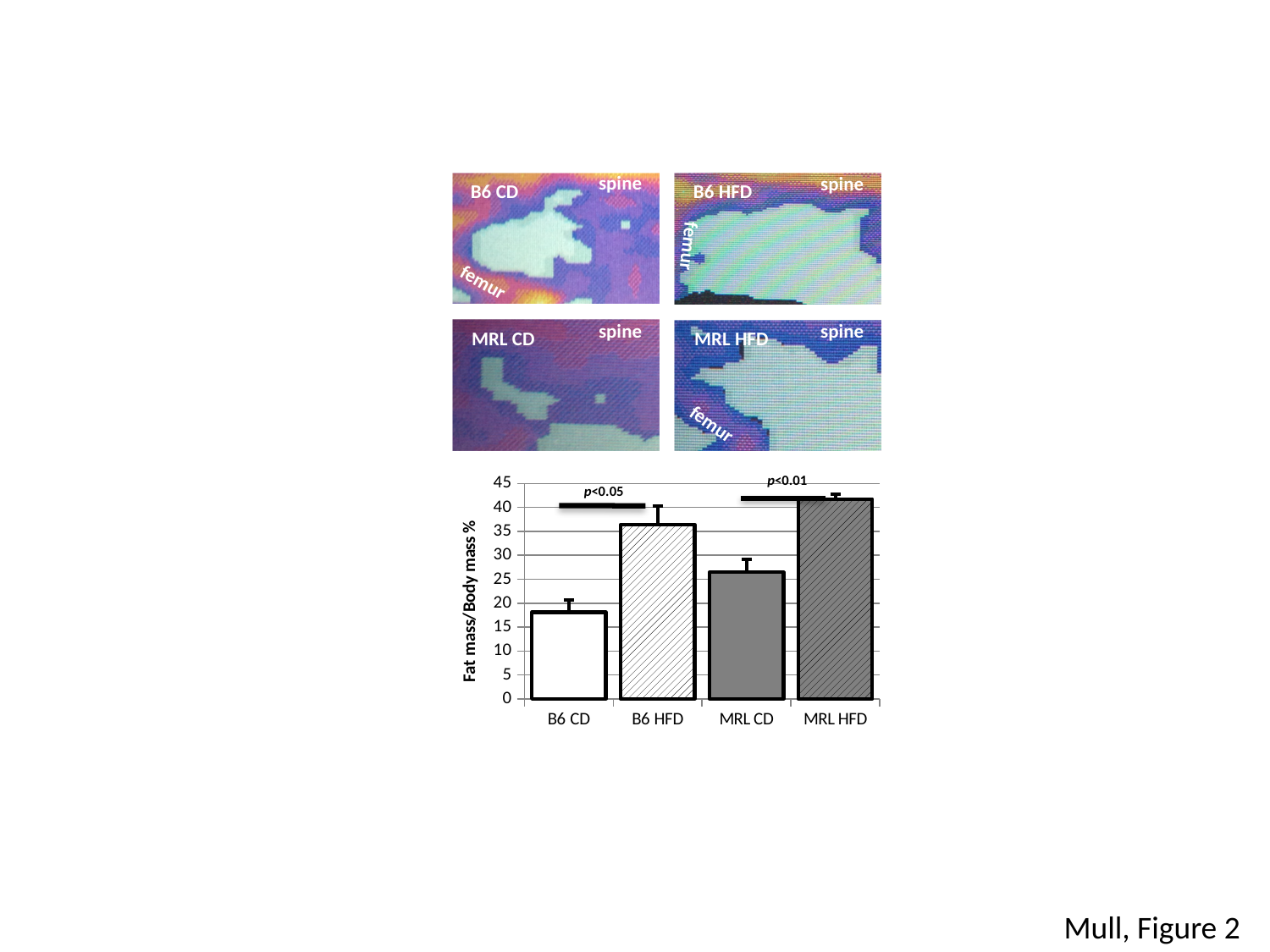
Which is larger, the value for B6 CD or the value for MRL CD? MRL CD What is the title of the y axis of the bar chart? Fat mass/Body mass % Is the value for B6 HFD greater or less than 30? greater Is the value for MRL CD greater or less than 30? less Which category has the highest Fat mass/Body mass %? MRL HFD How many categories are shown on the x axis of the bar chart? 4 What kind of chart is shown on the slide? bar chart What p-value annotation is shown above the B6 CD and B6 HFD bars? p<0.05 Which is larger, the value for B6 HFD or the value for MRL CD? B6 HFD Is the value for B6 CD greater or less than 20? less Which category has the lowest Fat mass/Body mass %? B6 CD